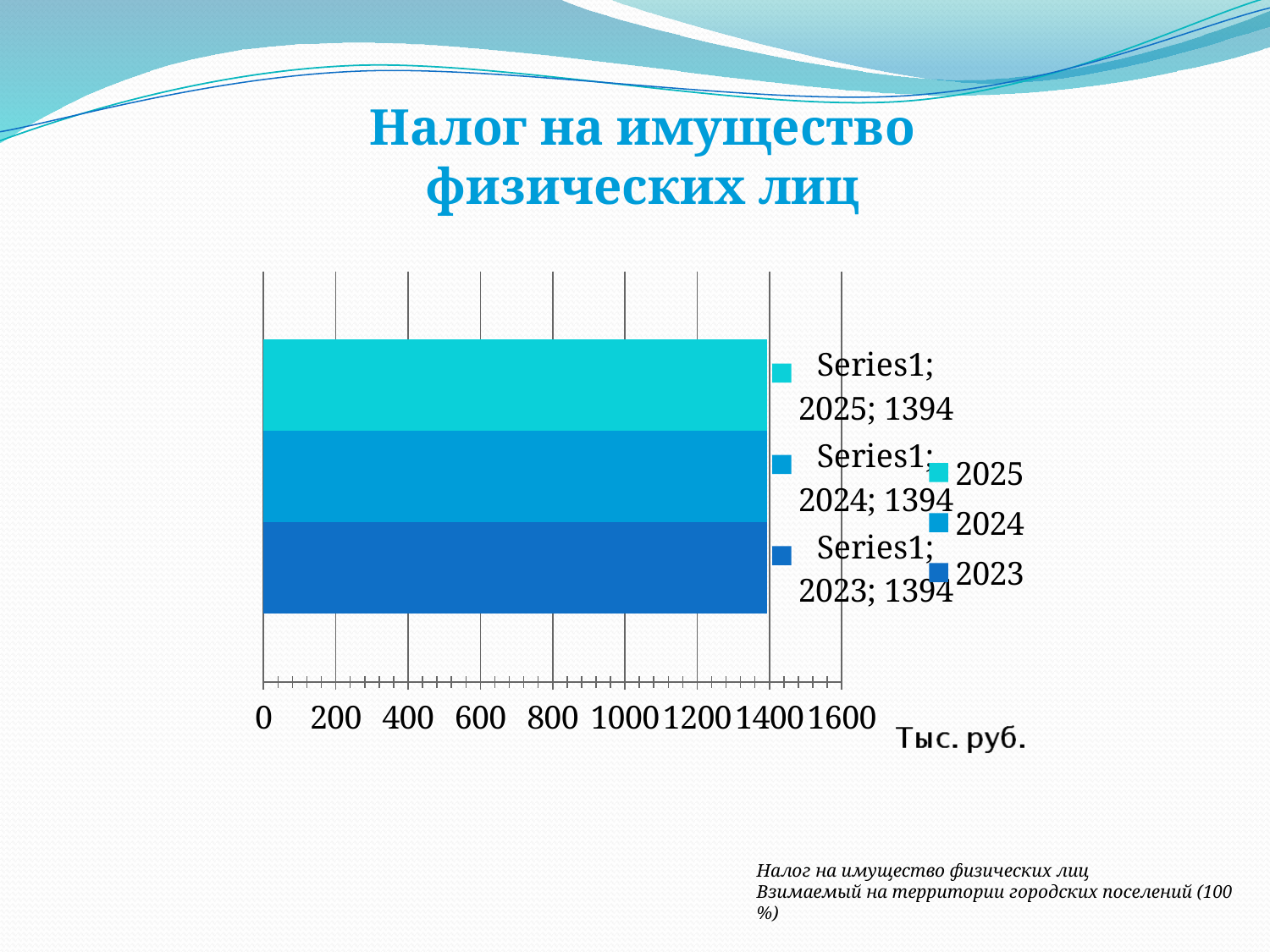
Is the value for 2024 greater or less than 1200? greater Do the values change from 2023 to 2025? No, they stay the same How many entries does the legend list? 3 What unit is shown on the horizontal axis? Тыс. руб. How many bars are plotted on the chart? 3 What kind of chart is shown on the slide? bar chart What is the value for 2024? 1394 What is the title of the chart? Налог на имущество физических лиц What is the value for 2025? 1394 What is the value for 2023? 1394 Is the value for 2023 greater or less than 1600? less What is the difference between the values for 2025 and 2023? 0